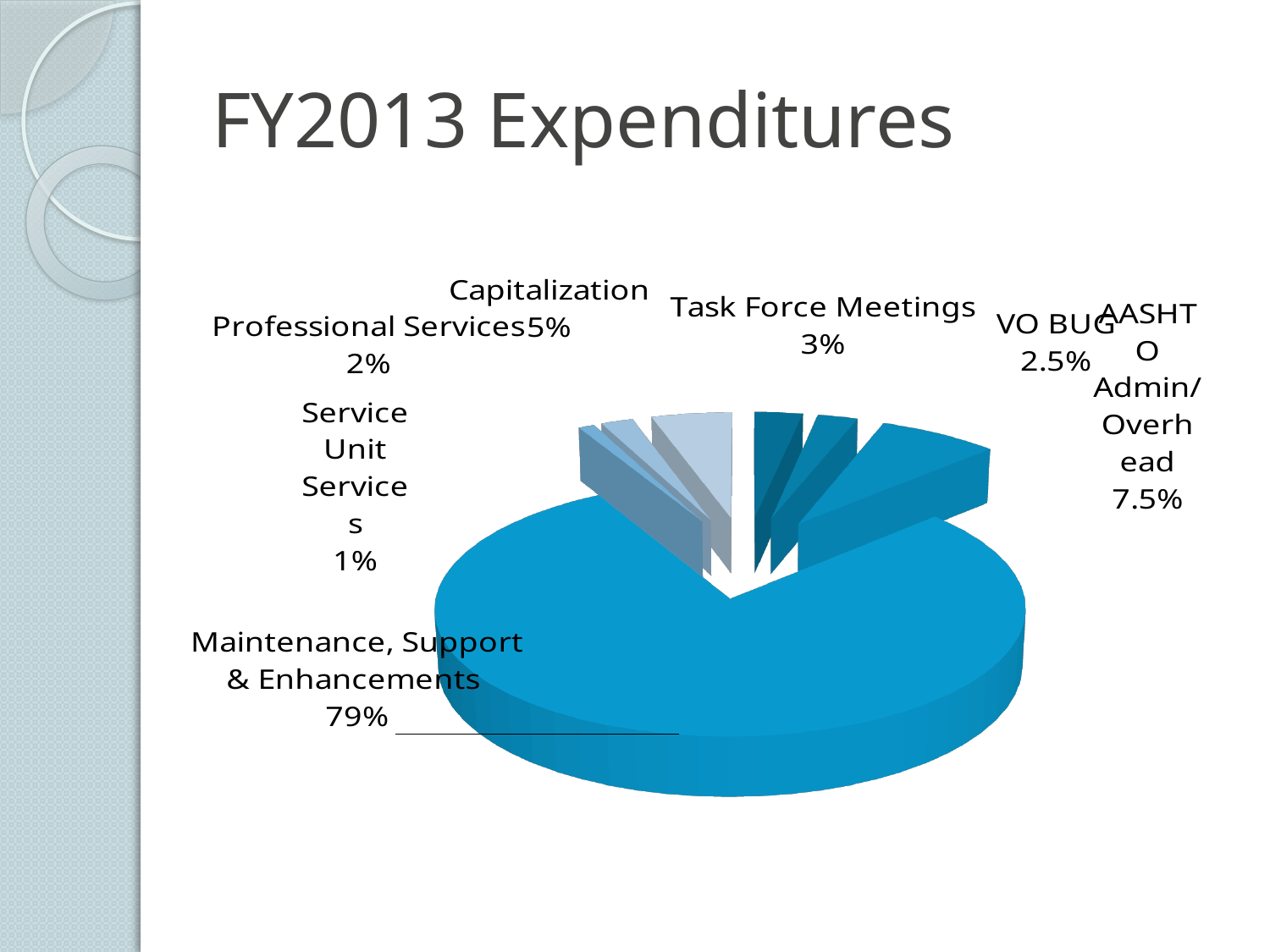
Which category has the largest share of the pie? Maintenance, Support & Enhancements What is the difference in percentage points between AASHTO Admin/Overhead and Professional Services? 5.5 How many slices does the pie chart have? 7 What percentage is shown for Task Force Meetings? 3% What kind of chart is shown on the slide? Pie chart What percentage is shown for VO BUG? 2.5% What percentage is shown for AASHTO Admin/Overhead? 7.5% What is the chart's title? FY2013 Expenditures What share of FY2013 expenditures is Maintenance, Support & Enhancements? 79% Which is larger, the share for Capitalization or the share for Task Force Meetings? Capitalization What percentage is shown for Capitalization? 5% Which category has the smallest share of the pie? Service Unit Services